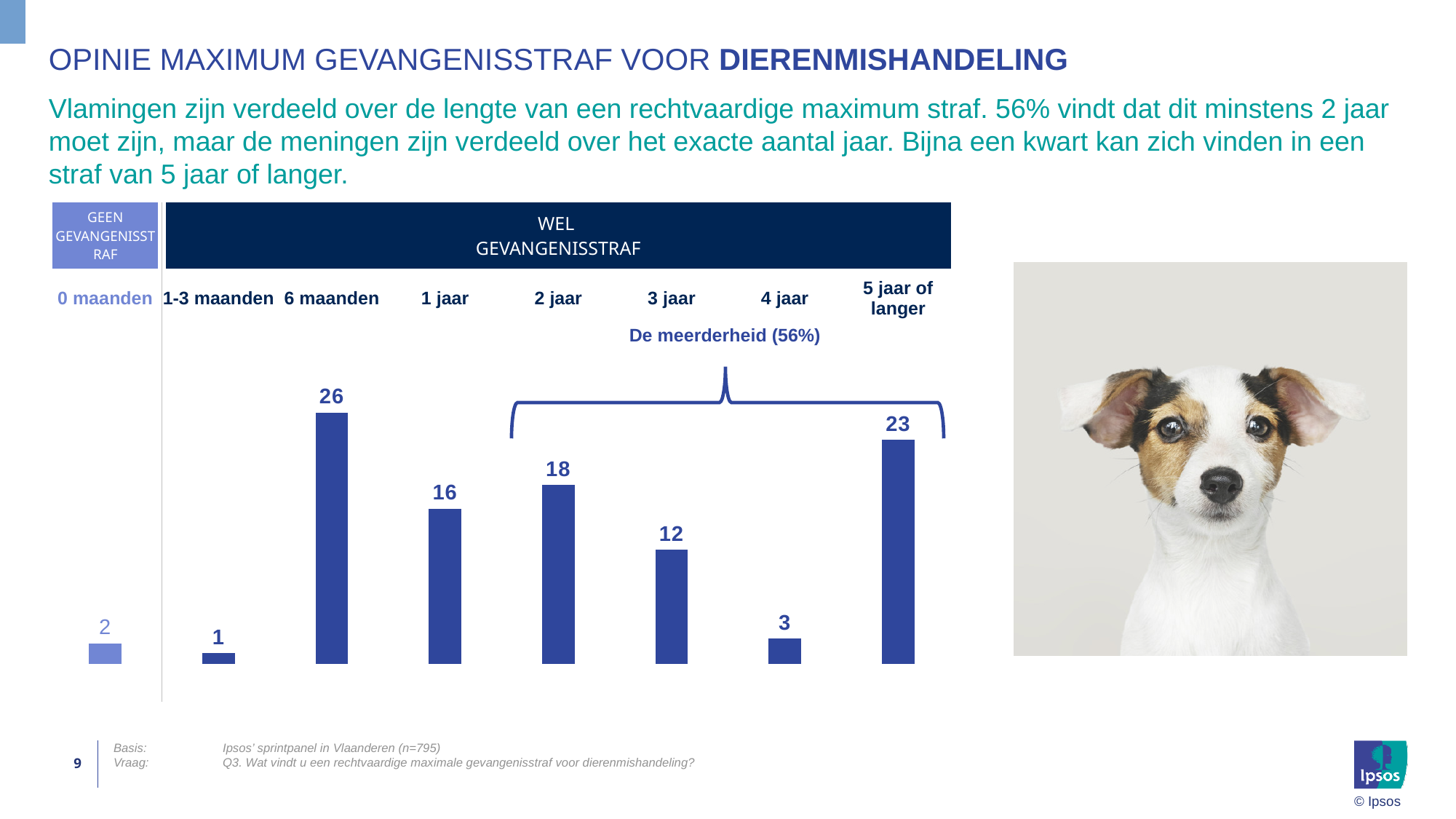
How many categories are shown in the chart? 8 What percentage is labelled as "De meerderheid" above the bracket in the chart? 56% What is the difference between the values for "2 jaar" and "1 jaar"? 2 What kind of chart is shown on the slide? bar chart Which is larger, the value for "2 jaar" or the value for "3 jaar"? 2 jaar What is the value for "5 jaar of langer"? 23 Which category has the highest value? 6 maanden Which category has the lowest value? 1-3 maanden What is the difference between the values for "6 maanden" and "5 jaar of langer"? 3 What is the value for "0 maanden"? 2 What is the value for "6 maanden"? 26 What is the value for "3 jaar"? 12